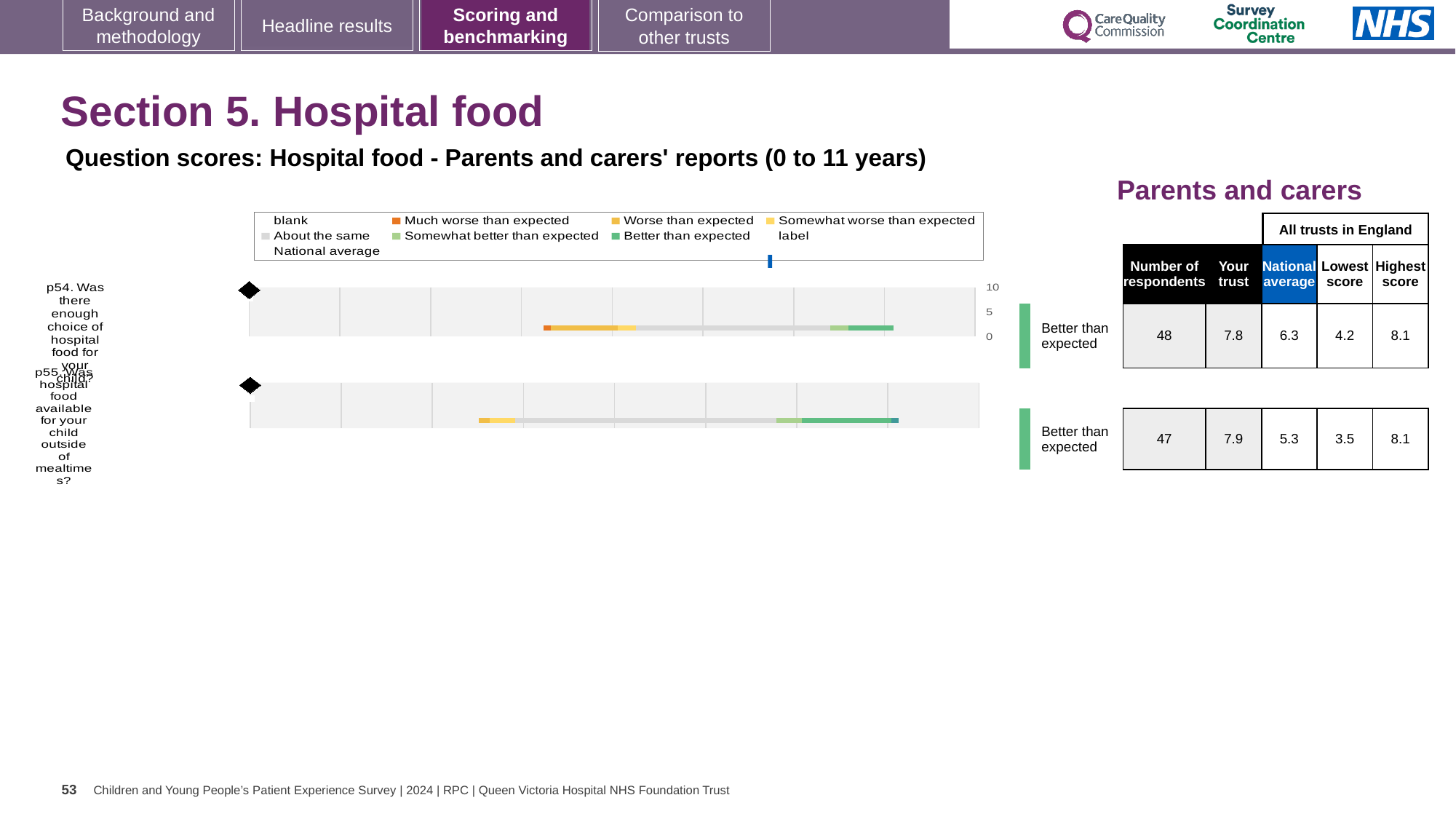
What benchmark category is shown for both p54 and p55? Better than expected What kind of chart is used to show the question scores for p54 and p55? bar chart What is the 'Your trust' score for p54 (Was there enough choice of hospital food for your child?)? 7.8 Which question has the higher 'Your trust' score, p54 or p55? p55 What is the highest value shown on the chart's score axis? 10 How many respondents answered p54? 48 What is the 'Your trust' score for p55 (Was hospital food available for your child outside of mealtimes?)? 7.9 How many questions (categories) are plotted in the benchmarking chart? 2 What is the difference between the 'Your trust' score and the national average for p55? 2.6 What is the lowest score among all trusts in England for p55? 3.5 What is the national average score for p54? 6.3 What is the national average score for p55? 5.3